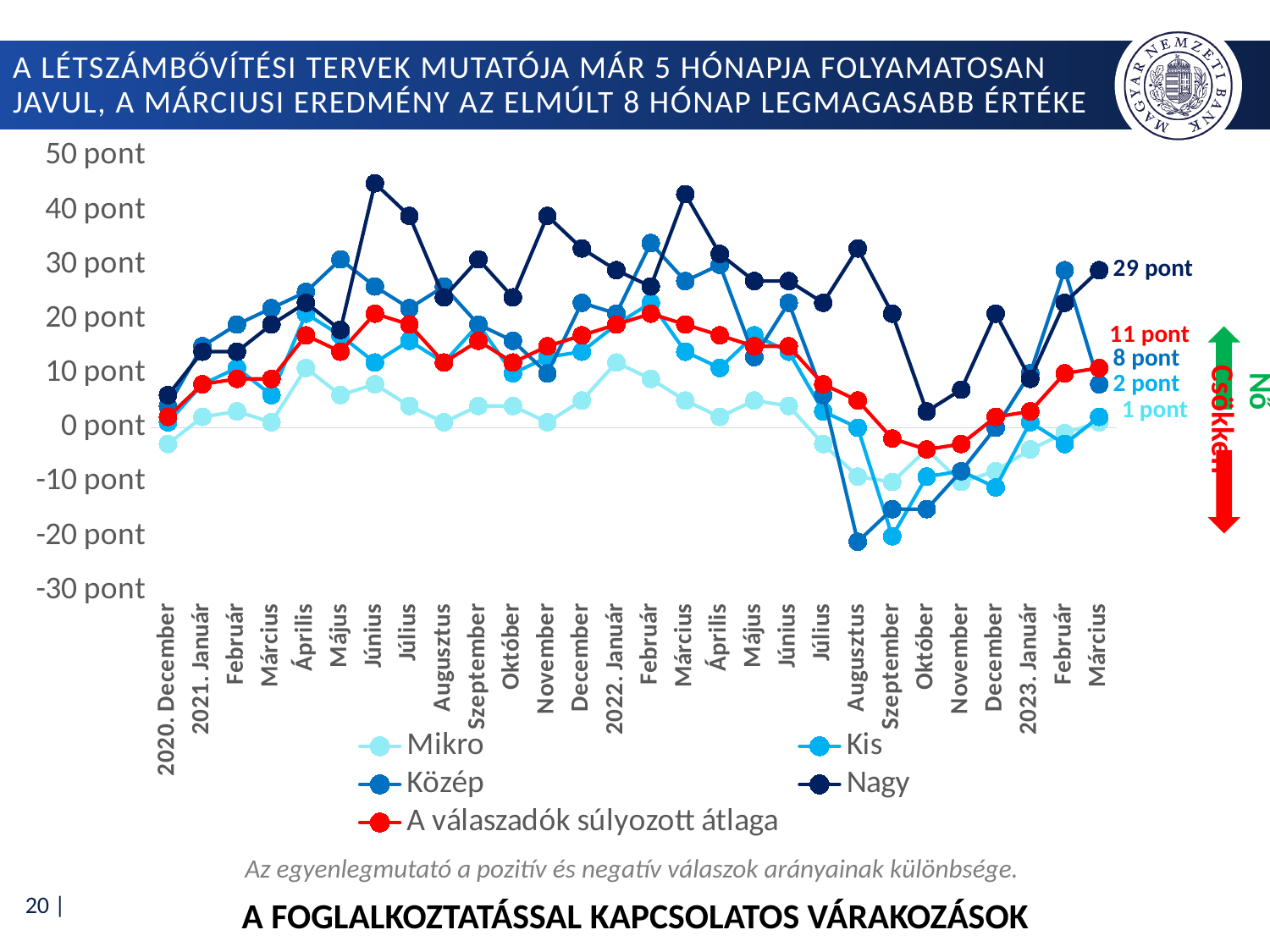
How many series does the legend list? 5 Is the value for the Közép series in 2022 Augusztus greater or less than -10 pont? less What is the difference between the Nagy and Közép values in 2023 Március? 21 pont What is the value for the Mikro series in 2023 Március? 1 pont Which series has the highest value in 2023 Március? Nagy What is the value of 'A válaszadók súlyozott átlaga' in 2023 Március? 11 pont What is the value for the Közép series in 2023 Március? 8 pont How many months (data points) are shown along the x axis? 28 What kind of chart is shown on the slide? line chart Is the value for the Nagy series in 2021 Június greater or less than 40 pont? greater What is the value for the Nagy series in 2023 Március? 29 pont What is the value for the Kis series in 2023 Március? 2 pont